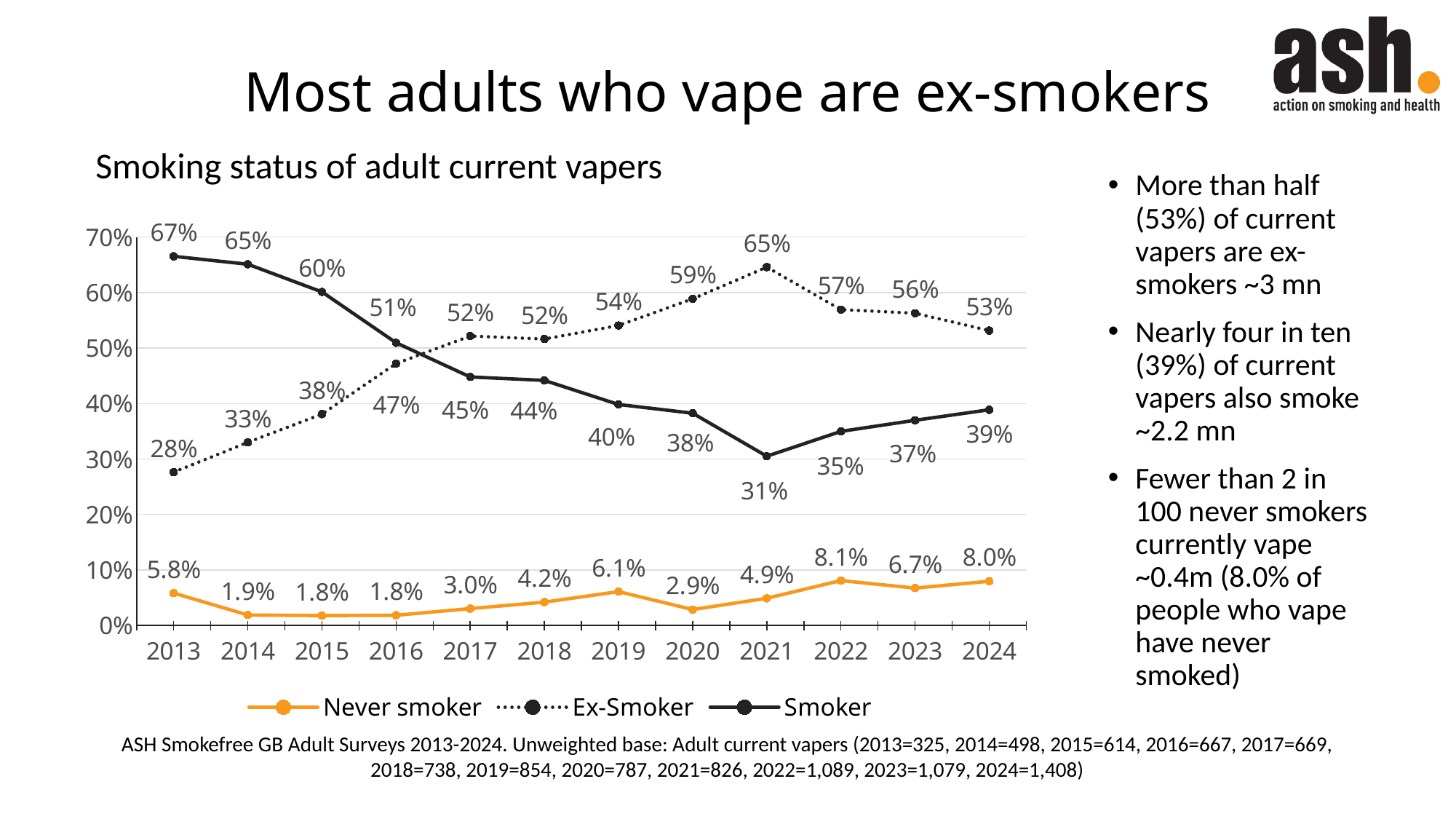
How many series does the legend list? 3 In 2016, which is larger: the Smoker value or the Ex-Smoker value? Smoker How many years are plotted on the x axis? 12 What is the value for Never smoker in 2022? 8.1% What is the title of the chart? Smoking status of adult current vapers What is the value for Ex-Smoker in 2021? 65% What is the difference between the Ex-Smoker and Smoker values in 2024? 14 percentage points In which year is the Ex-Smoker series at its highest? 2021 What kind of chart is shown on the slide? Line chart Does the Smoker series rise or fall from 2013 to 2021? Fall In which year is the Smoker series at its lowest? 2021 What is the value for Smoker in 2013? 67%